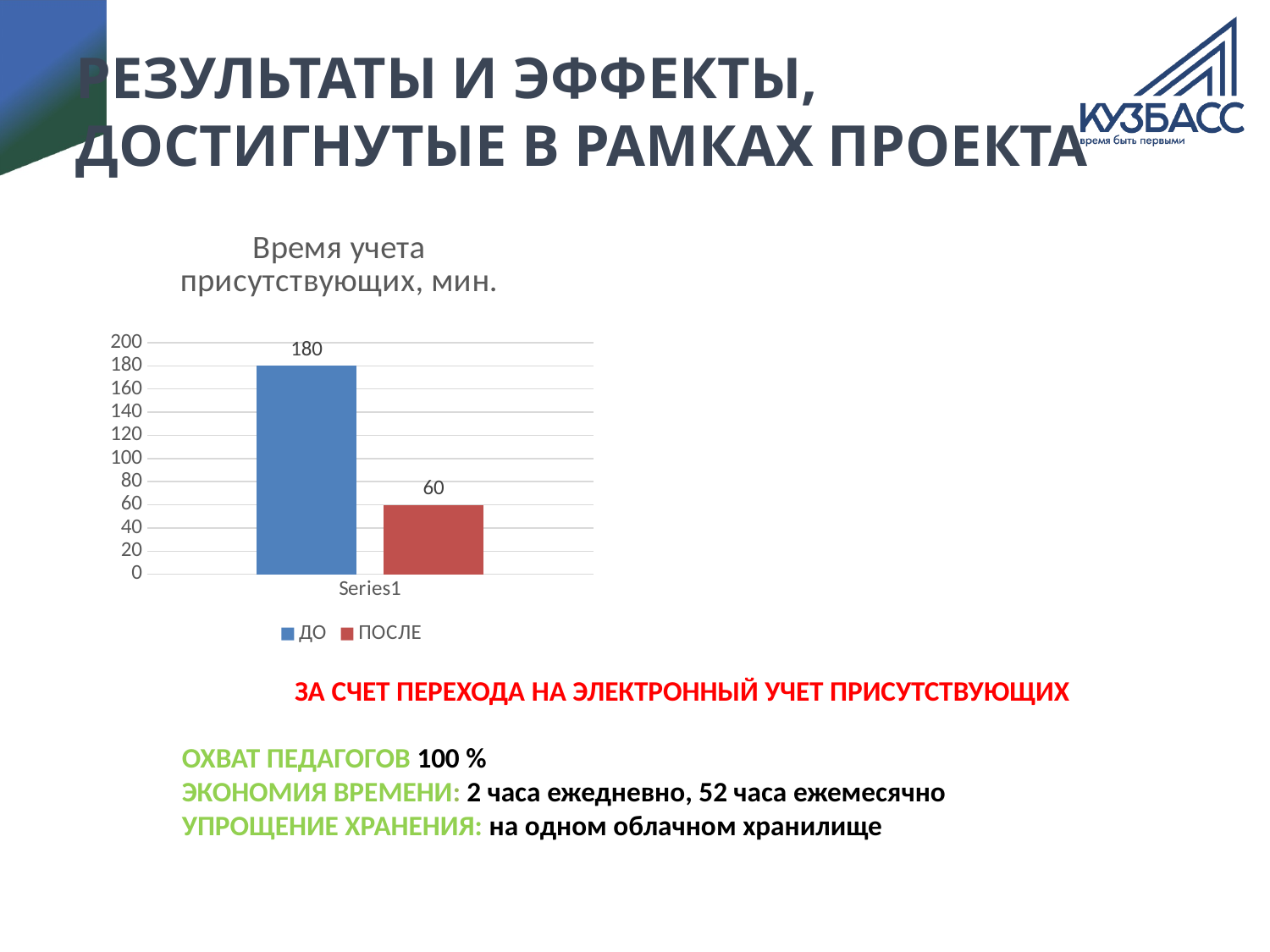
Which series has the lowest value in the chart? ПОСЛЕ Is the value for ДО greater or less than 160? greater What is the title of the chart? Время учета присутствующих, мин. What kind of chart is shown on the slide? bar chart Which series has the highest value in the chart? ДО How many series does the legend list? 2 What is the difference between the values for ДО and ПОСЛЕ? 120 Which is larger, the value for ДО or the value for ПОСЛЕ? ДО What is the value for ДО in the chart? 180 What colour is the bar for ПОСЛЕ? red What is the value for ПОСЛЕ in the chart? 60 Is the value for ПОСЛЕ greater or less than 100? less